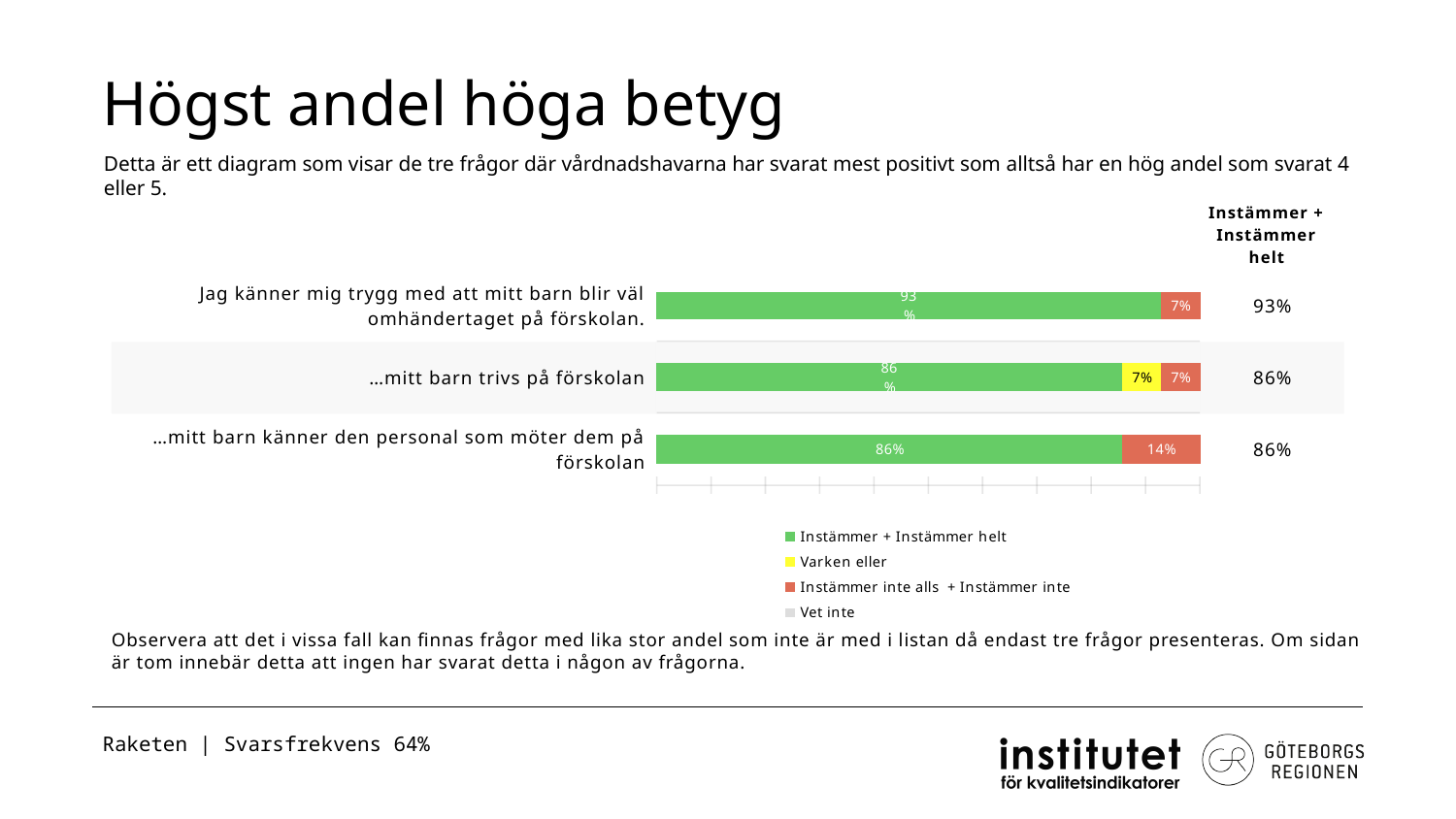
What is the 'Varken eller' share for '…mitt barn trivs på förskolan'? 7% How many series does the legend list? 4 What is the difference between the 'Instämmer + Instämmer helt' share for 'Jag känner mig trygg med att mitt barn blir väl omhändertaget på förskolan' and for '…mitt barn trivs på förskolan'? 7 percentage points How many questions (categories) are plotted in the chart? 3 What is the title of the slide containing the chart? Högst andel höga betyg What kind of chart is shown on the slide? Stacked bar chart What is the total of the stacked bar for '…mitt barn trivs på förskolan'? 100% What is the 'Instämmer + Instämmer helt' share for '…mitt barn trivs på förskolan'? 86% Which question has the highest 'Instämmer + Instämmer helt' share? Jag känner mig trygg med att mitt barn blir väl omhändertaget på förskolan What is the 'Instämmer + Instämmer helt' share for 'Jag känner mig trygg med att mitt barn blir väl omhändertaget på förskolan'? 93% What is the 'Instämmer inte alls + Instämmer inte' share for '…mitt barn känner den personal som möter dem på förskolan'? 14% Which is larger: the 'Instämmer inte alls + Instämmer inte' share for '…mitt barn känner den personal som möter dem på förskolan' or for 'Jag känner mig trygg med att mitt barn blir väl omhändertaget på förskolan'? …mitt barn känner den personal som möter dem på förskolan